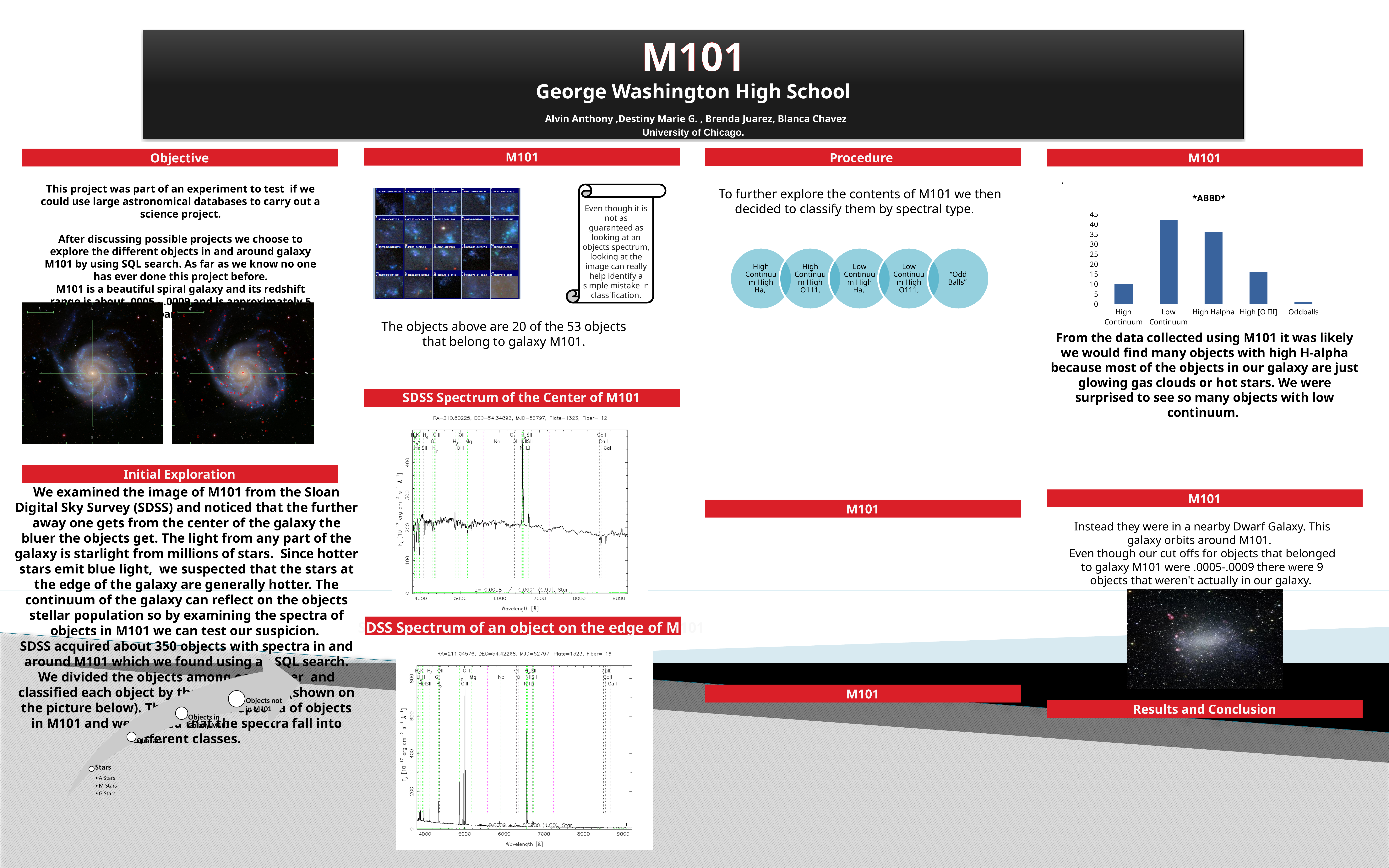
In the *ABBD* bar chart, which is larger, the value for Low Continuum or the value for High Halpha? Low Continuum In the *ABBD* bar chart, is the value for High Halpha greater or less than 40? less What is the title of the bar chart on the slide? *ABBD* In the *ABBD* bar chart, is the value for Low Continuum greater or less than 40? greater In the *ABBD* bar chart, which is larger, the value for High Continuum or the value for High [O III]? High [O III] In the *ABBD* bar chart, which category has the highest bar? Low Continuum In the *ABBD* bar chart, is the value for Oddballs greater or less than 5? less In the *ABBD* bar chart, how many categories are shown on the x axis? 5 In the *ABBD* bar chart, which category has the lowest bar? Oddballs What kind of chart is the chart titled *ABBD*? bar chart What is the highest value shown on the y axis of the *ABBD* bar chart? 45